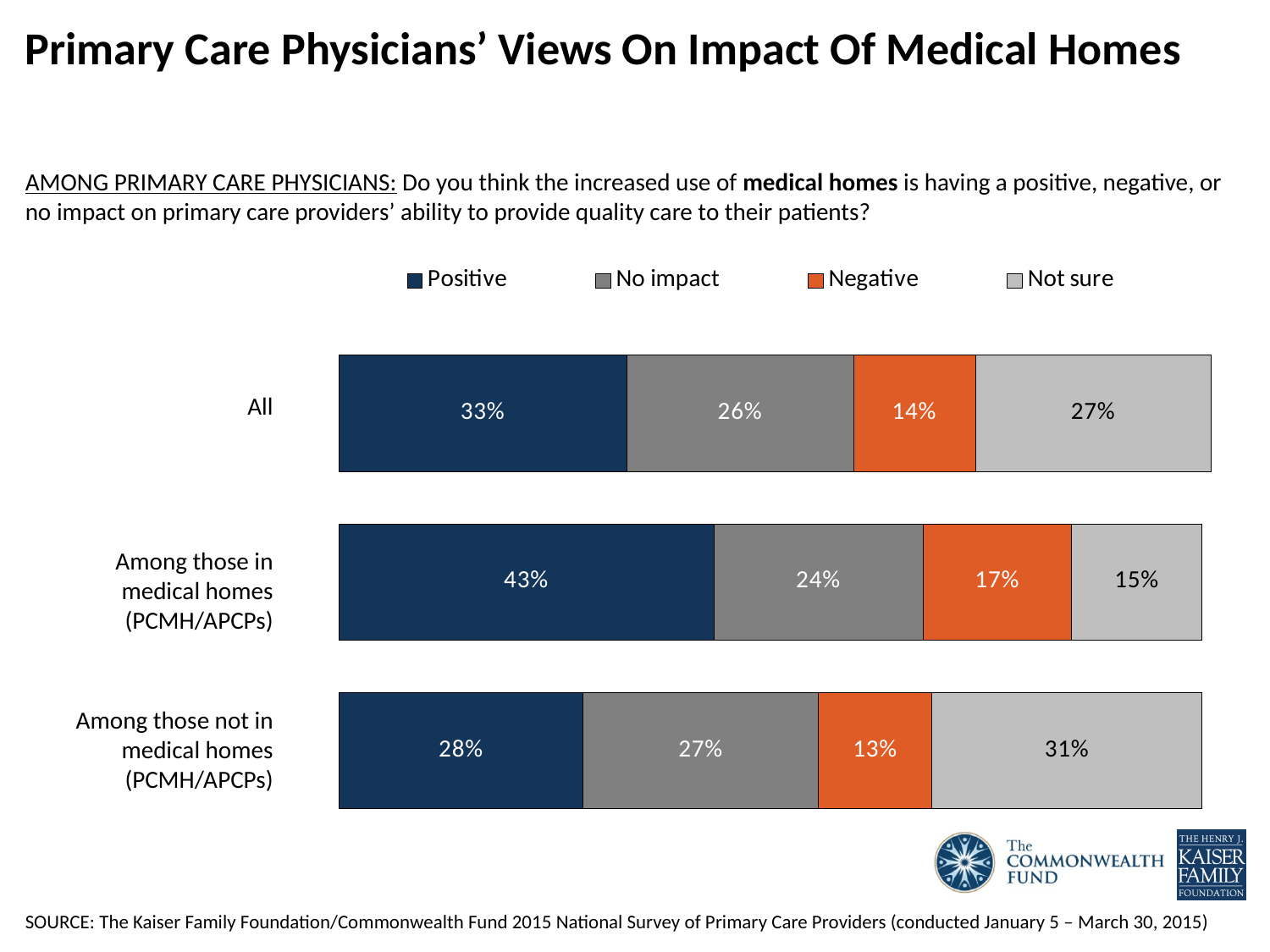
What is the 'Not sure' value for those not in medical homes (PCMH/APCPs)? 31% What percentage of all primary care physicians said medical homes have a positive impact? 33% Which group has the highest 'Positive' value? Among those in medical homes (PCMH/APCPs) How many groups (bars) are shown in the chart? 3 What is the total of the 'Positive' and 'No impact' values for the All group? 59% How many series does the legend list? 4 Which group has the lowest 'Not sure' value? Among those in medical homes (PCMH/APCPs) Which legend entry is shown in orange? Negative What is the 'Negative' value for those in medical homes (PCMH/APCPs)? 17% What kind of chart is shown on the slide? Stacked bar chart Is the 'No impact' value larger for the All group or for those not in medical homes? Among those not in medical homes (PCMH/APCPs) What is the difference between the 'Positive' values for those in medical homes and those not in medical homes? 15 percentage points